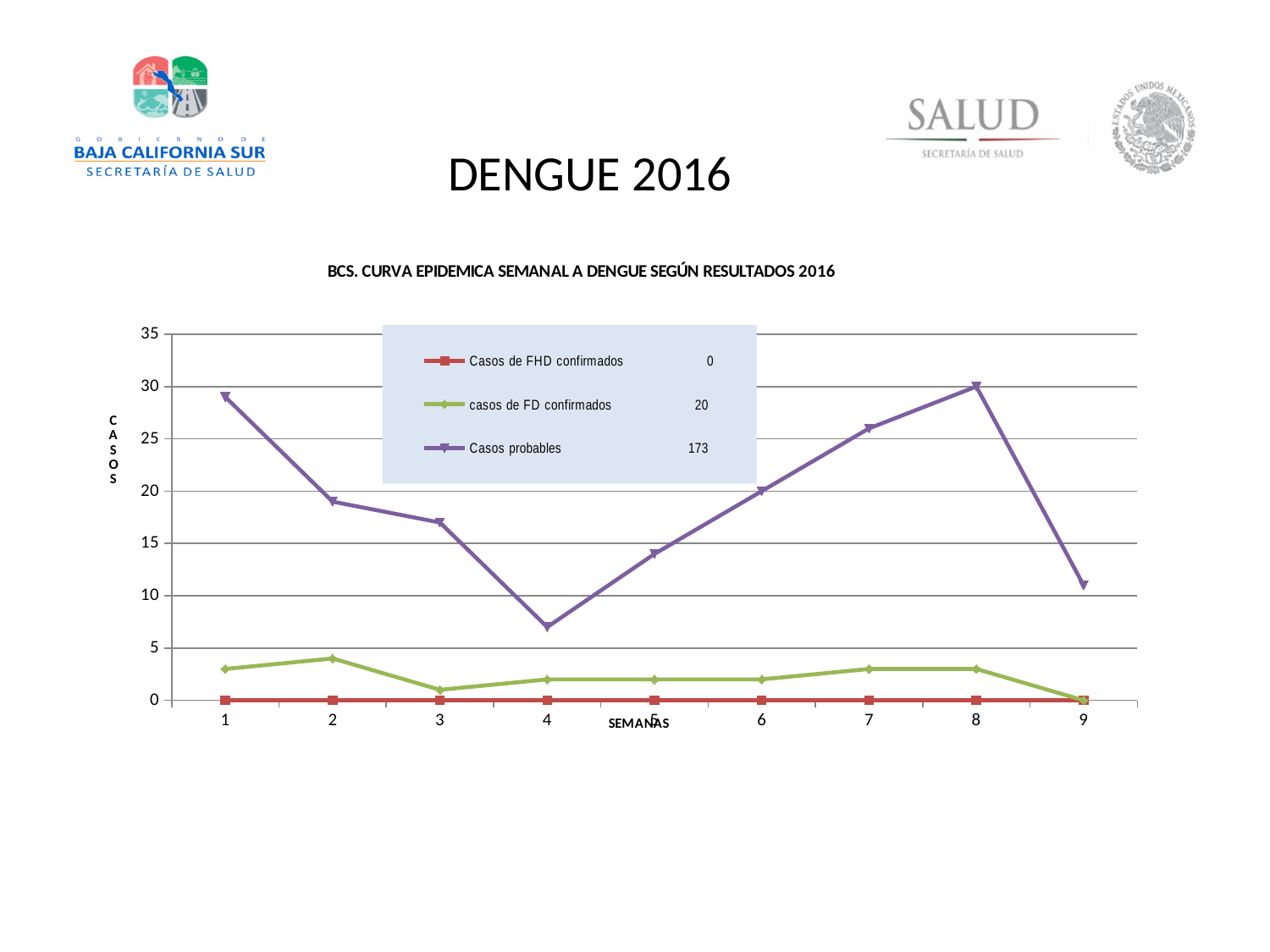
In which week does the Casos probables line reach its highest value? 8 What total is shown in the legend for casos de FD confirmados? 20 What total is shown in the legend for Casos probables? 173 How many weeks (semanas) are plotted along the x axis? 9 How many series does the legend list? 3 What is the value of Casos probables in week 8? 30 Is the value of Casos probables in week 4 greater or less than 10? less What kind of chart is shown on the slide? line chart In which week does the Casos probables line reach its lowest value? 4 Is the value of Casos probables in week 1 greater or less than 25? greater What total is shown in the legend for Casos de FHD confirmados? 0 Do the Casos probables values rise or fall from week 4 to week 8? rise